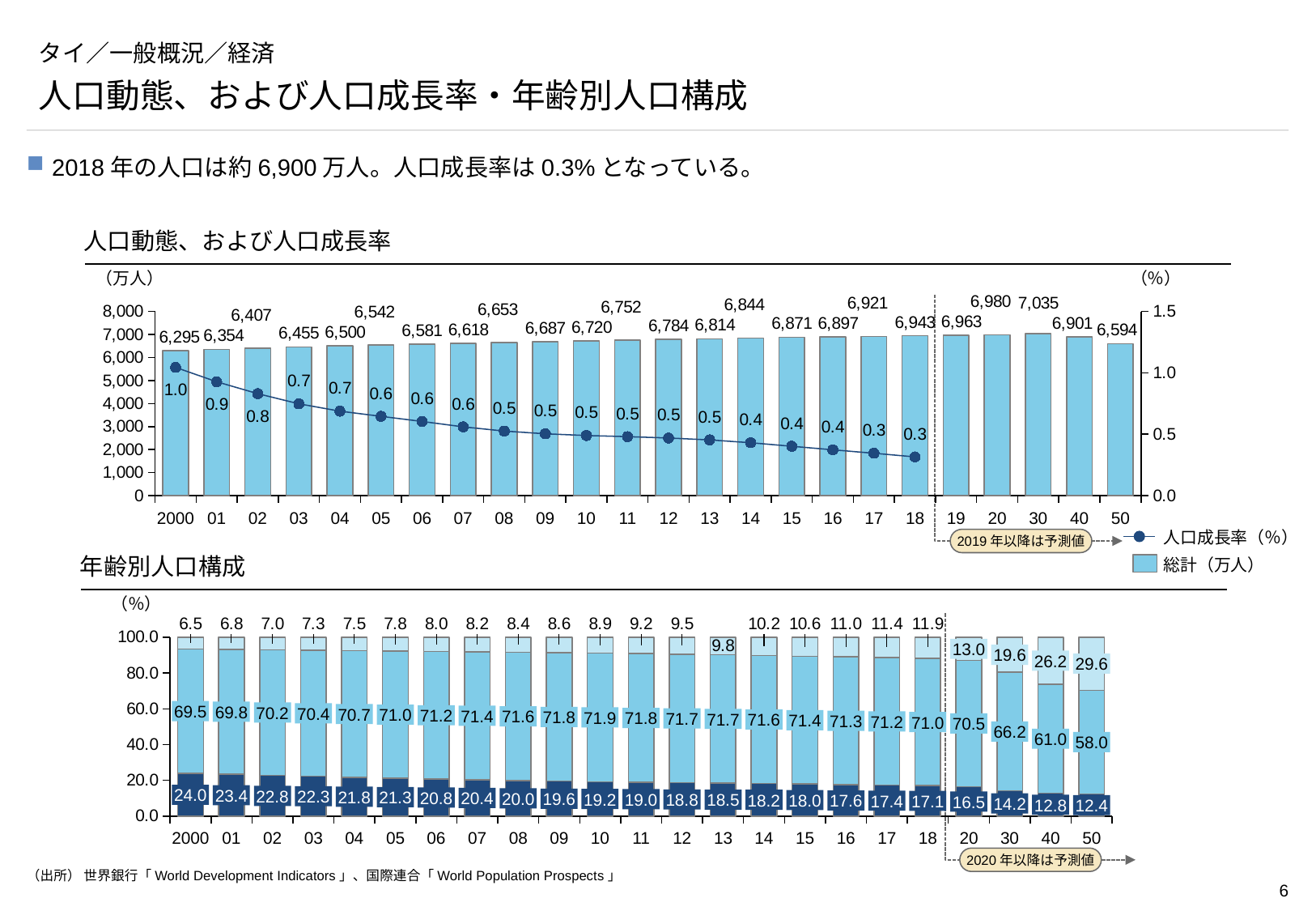
In the top chart (人口動態、および人口成長率), how many series does the legend list? 2 In the top chart (人口動態、および人口成長率), which year has the lowest total population bar? 2000 In the bottom chart (年齢別人口構成), how many stacked bars are plotted? 23 In the top chart (人口動態、および人口成長率), does the population growth rate line rise or fall from 2000 to 2018? fall In the bottom chart (年齢別人口構成), what is the value of the bottom dark-blue segment for 2000? 24.0 In the top chart (人口動態、および人口成長率), which year has the highest total population bar? 30 (2030) In the top chart (人口動態、および人口成長率), what is the population growth rate (人口成長率) shown for 2000? 1.0 In the top chart (人口動態、および人口成長率), from which year onward are the values forecasts (予測値)? 2019 In the bottom chart (年齢別人口構成), what is the value of the top light-blue segment for 50 (2050)? 29.6 In the top chart (人口動態、および人口成長率), what is the total population (総計) value shown for 2018? 6,943 In the top chart (人口動態、および人口成長率), what is the difference between the total population in 2018 and in 2000? 648 In the bottom chart (年齢別人口構成), is the middle segment larger in 2010 or in 50 (2050)? 2010